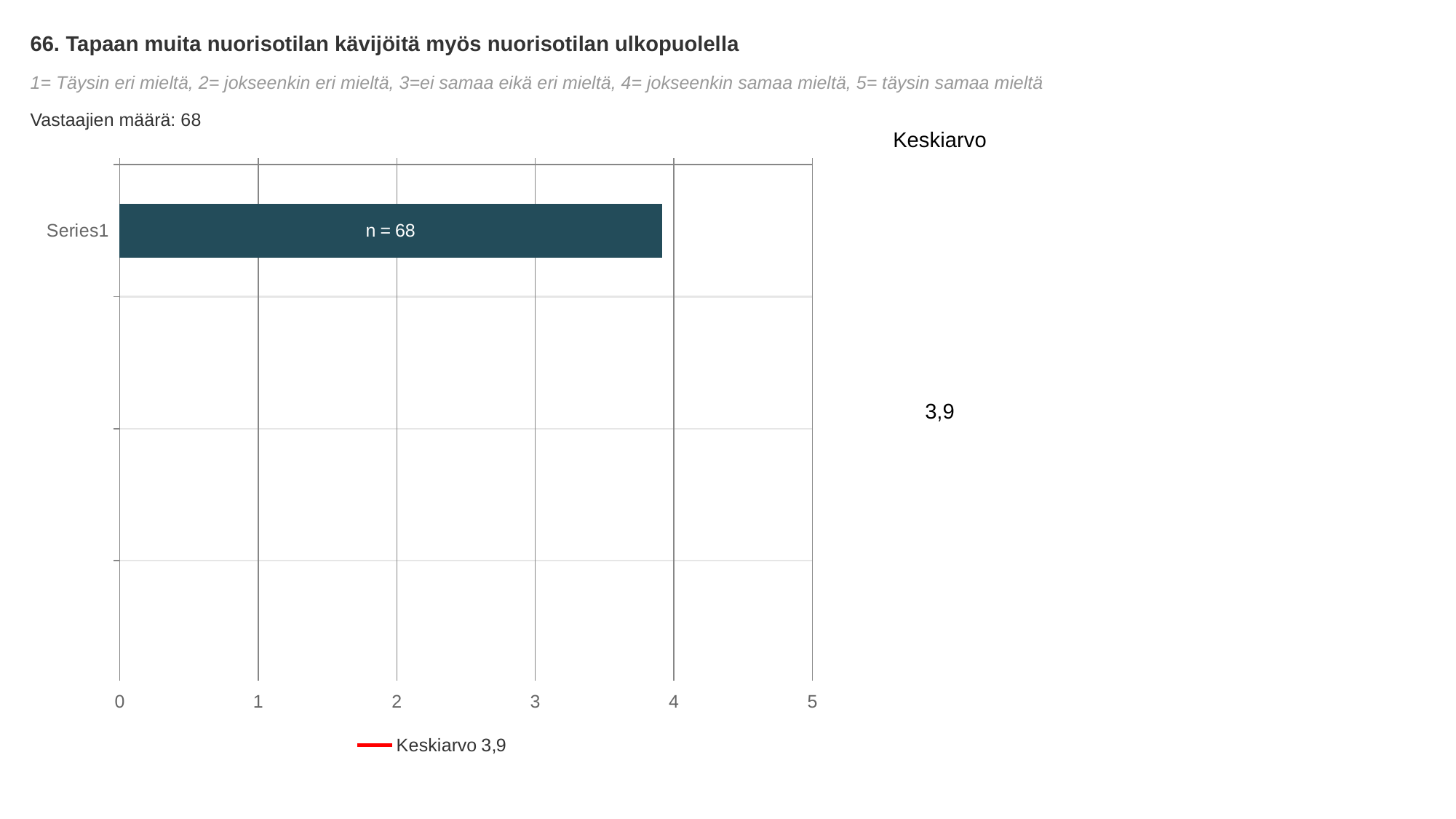
What is the title of the slide's chart question? 66. Tapaan muita nuorisotilan kävijöitä myös nuorisotilan ulkopuolella What kind of chart is shown on the slide? bar chart Is the value for Series1 greater or less than 2? greater What is the data label printed on the Series1 bar? n = 68 What is the number of respondents (Vastaajien määrä) stated on the slide? 68 Is the value for Series1 greater or less than 4? less What is the label of the category on the vertical axis? Series1 What is the Keskiarvo (mean) value shown on the slide? 3,9 What text does the legend entry below the chart show? Keskiarvo 3,9 Is the value for Series1 greater or less than 3? greater How many bars are plotted in the chart? 1